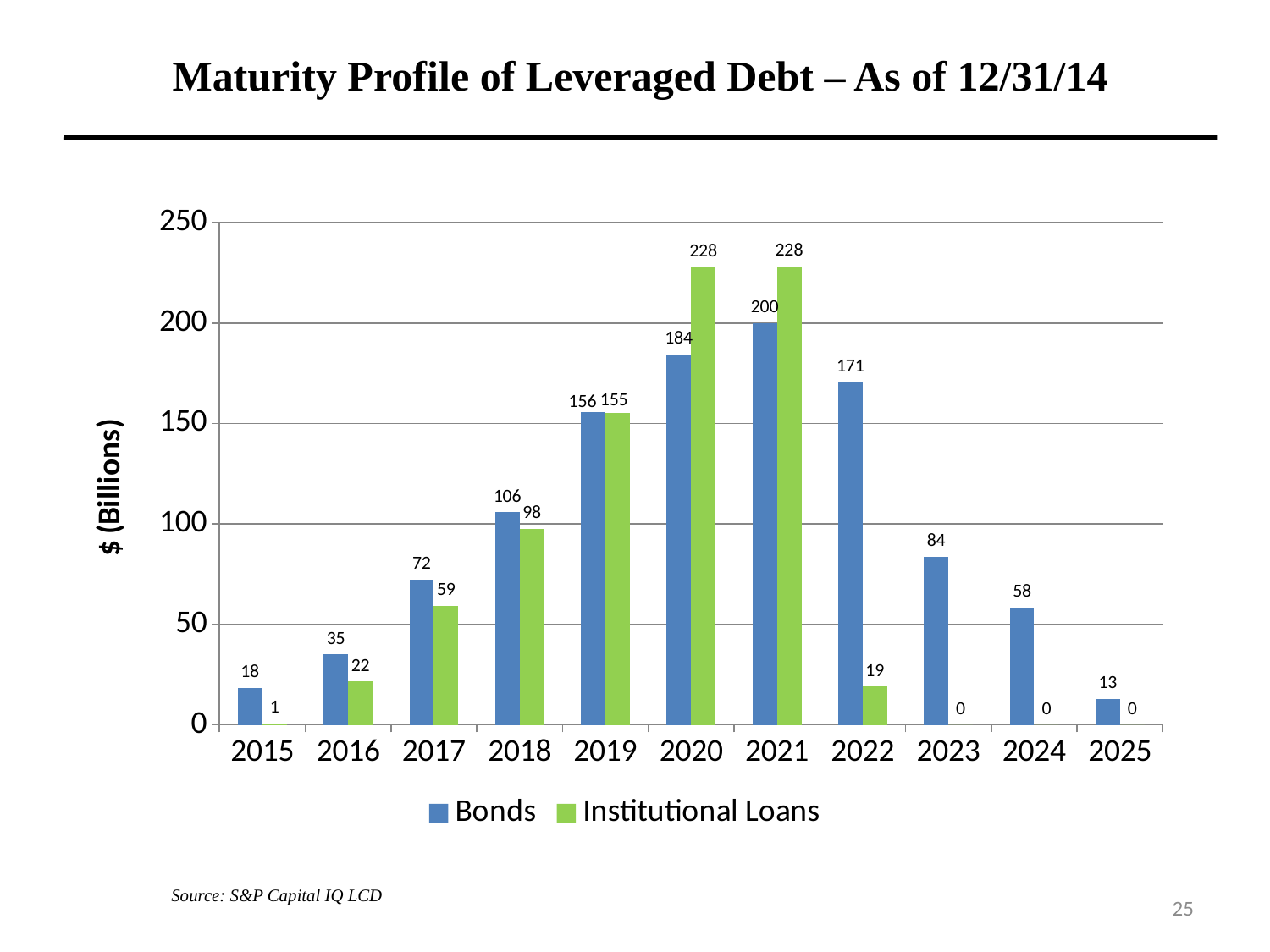
Which is larger in 2020, Bonds or Institutional Loans? Institutional Loans What is the value for Bonds in 2021? 200 In which year is the Bonds value highest? 2021 Is the Bonds value for 2023 greater or less than 100? less What is the value for Institutional Loans in 2015? 1 How many years are shown on the x axis? 11 How many series does the legend list? 2 What kind of chart is shown on the slide? bar chart What is the difference between Bonds and Institutional Loans in 2022? 152 What is the label of the y axis? $ (Billions) What is the value for Institutional Loans in 2018? 98 In which year is the Bonds value lowest? 2025